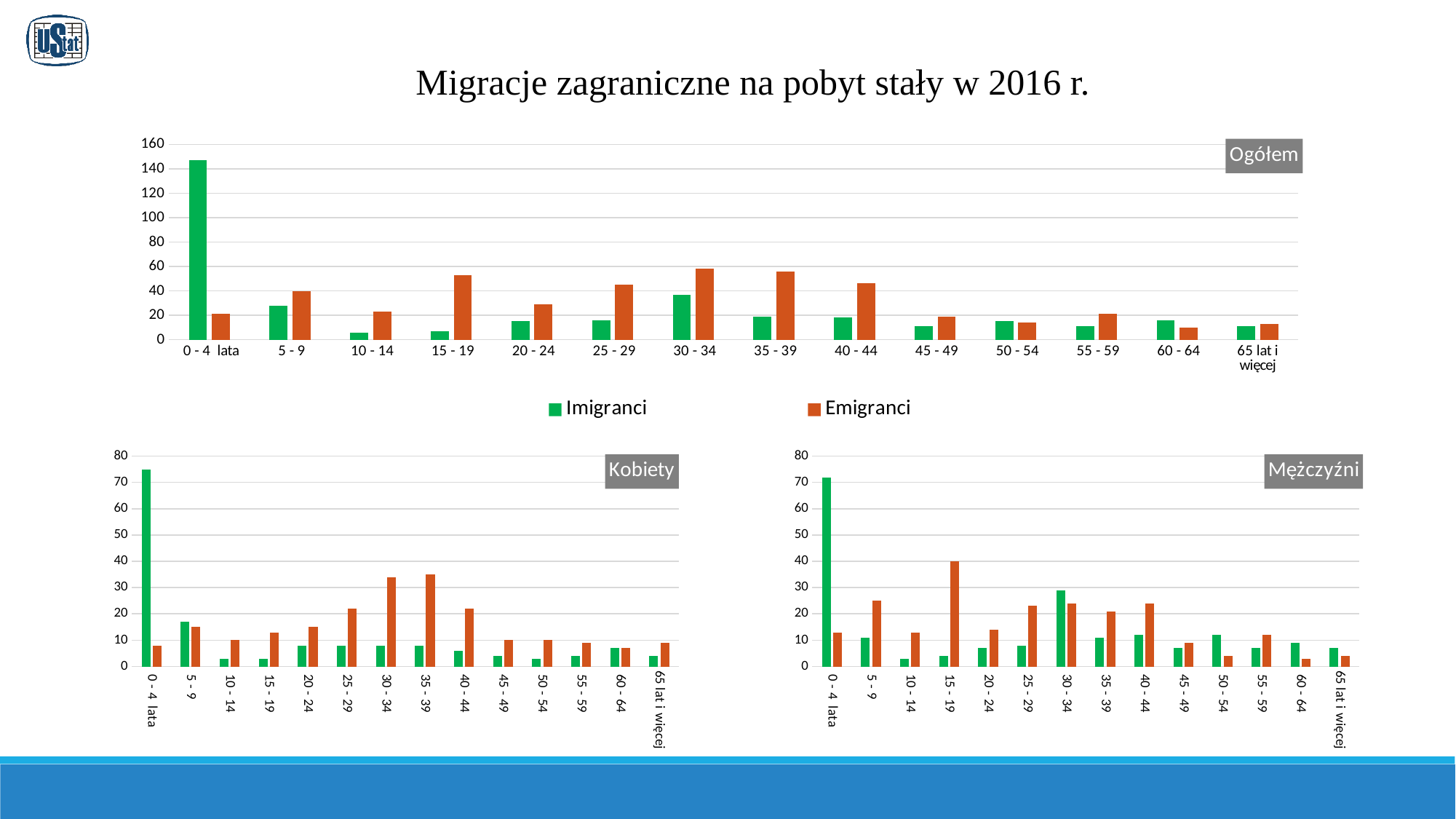
In the 'Ogółem' chart, for the 15 - 19 age group, which is larger: Imigranci or Emigranci? Emigranci Which colour represents the Imigranci series in the legend? green In the 'Mężczyźni' chart, which age category has the highest Emigranci value? 15 - 19 How many series does the legend list? 2 In the 'Ogółem' chart, is the Emigranci value for 30 - 34 greater or less than 40? greater In the 'Kobiety' chart, is the Imigranci value for 0 - 4 lata greater or less than 60? greater In the 'Ogółem' chart, which age category has the highest Imigranci value? 0 - 4 lata What kind of chart is the 'Ogółem' chart? bar chart In the 'Kobiety' chart, which age category has the highest Imigranci value? 0 - 4 lata In the 'Mężczyźni' chart, for the 30 - 34 age group, which is larger: Imigranci or Emigranci? Imigranci In the 'Ogółem' chart, is the Imigranci value for 0 - 4 lata greater or less than 120? greater How many age categories are shown on the 'Ogółem' chart? 14